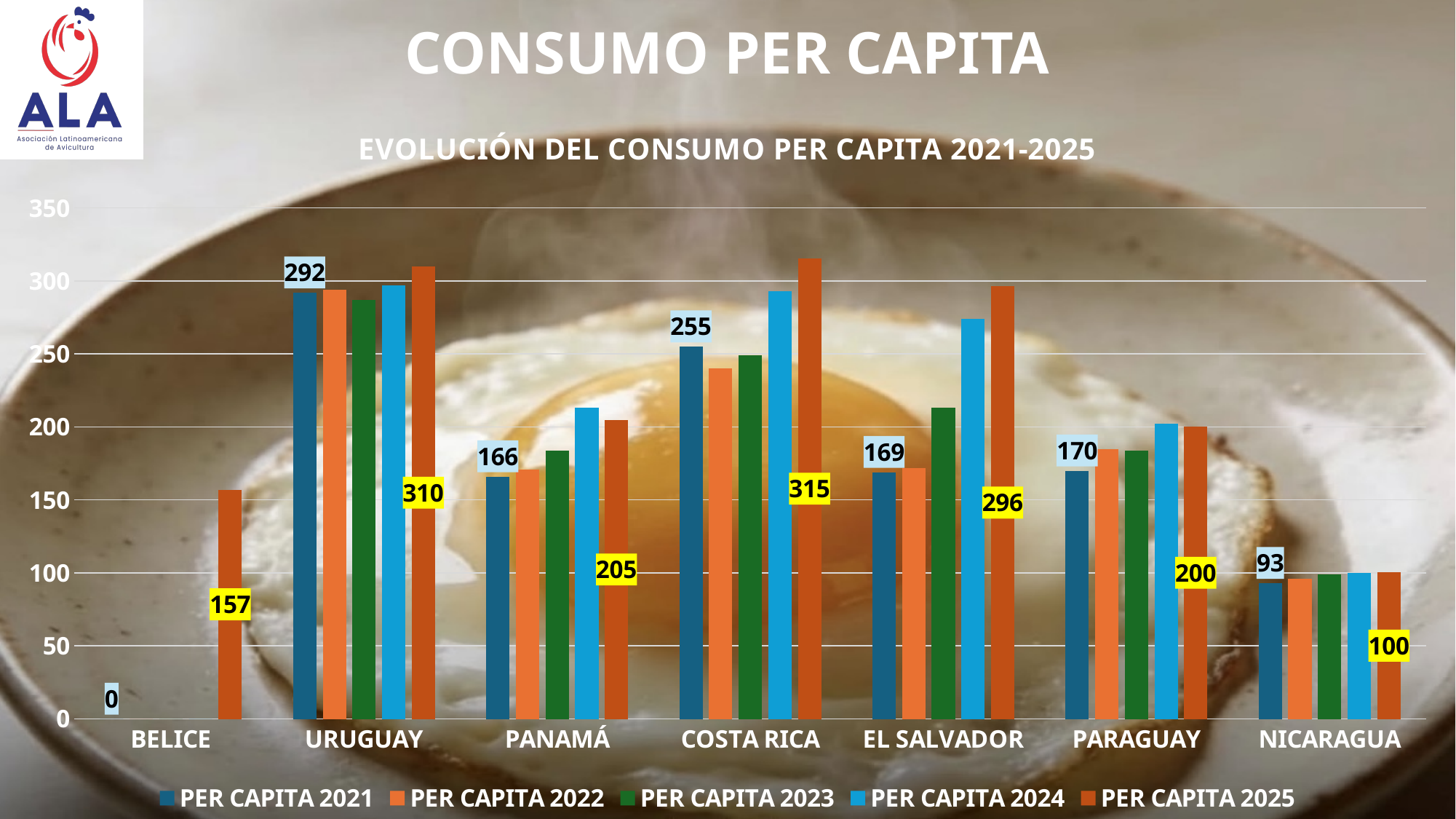
How many series does the legend list? 5 Which country has the highest PER CAPITA 2025 value? COSTA RICA Which country has the lowest PER CAPITA 2025 value? NICARAGUA How many countries are shown on the x axis? 7 What is the PER CAPITA 2021 value for BELICE? 0 What is the PER CAPITA 2025 value for COSTA RICA? 315 What is the difference between the PER CAPITA 2025 and PER CAPITA 2021 values for COSTA RICA? 60 What is the difference between the PER CAPITA 2025 and PER CAPITA 2021 values for EL SALVADOR? 127 Is the PER CAPITA 2024 value for URUGUAY greater or less than 250? greater What is the PER CAPITA 2021 value for URUGUAY? 292 Is the PER CAPITA 2022 value for PANAMÁ greater or less than 200? less Which is larger, the PER CAPITA 2021 value for COSTA RICA or for EL SALVADOR? COSTA RICA